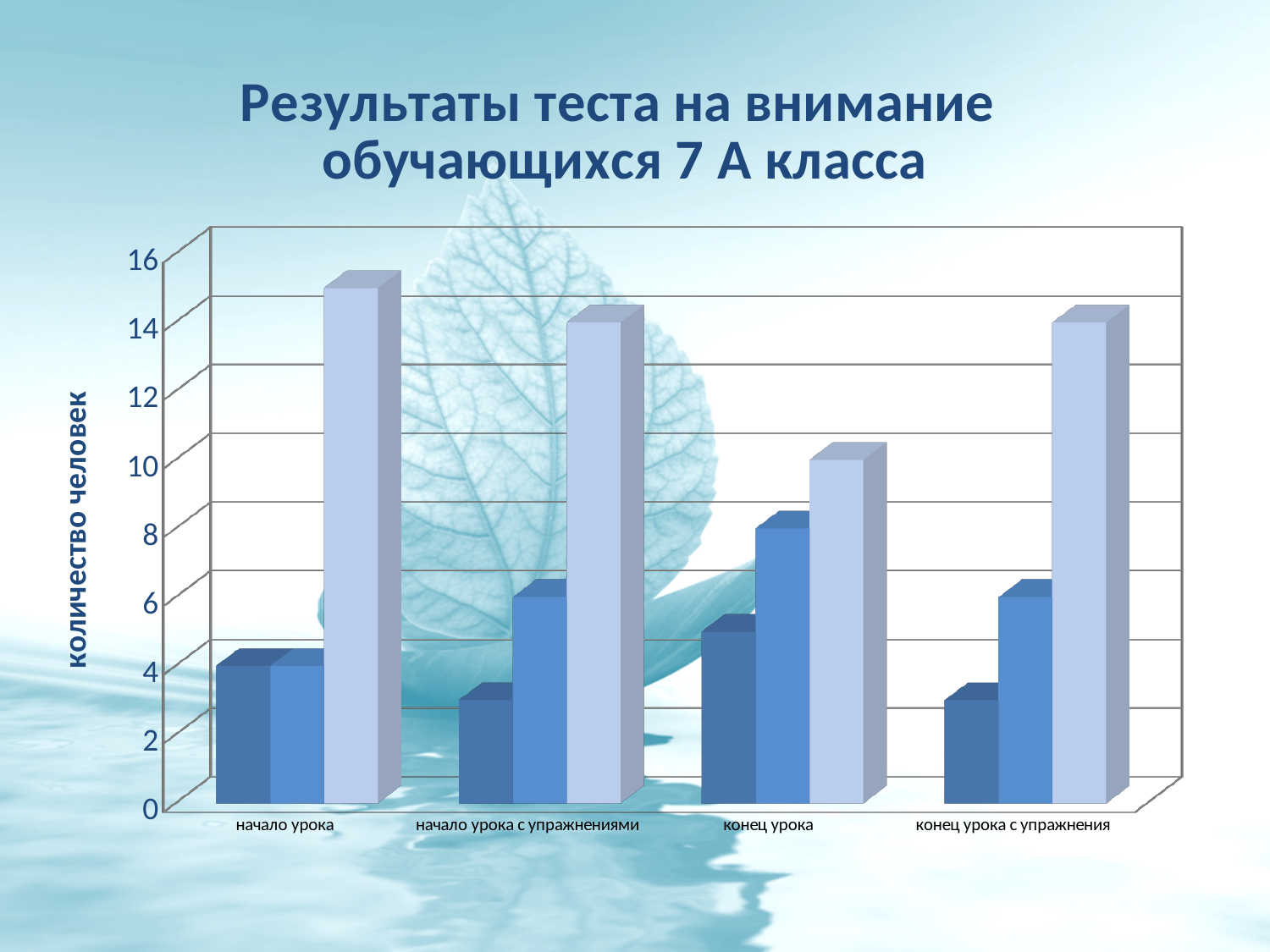
What is the title of the slide? Результаты теста на внимание обучающихся 7 А класса Is the value of the tallest (light-coloured) bar for 'начало урока' greater or less than 12? greater Which category has the tallest medium blue (second) bar? конец урока Which category has the shortest light-coloured (third) bar? конец урока What is the title of the chart's vertical axis? количество человек Is the value of the medium blue (second) bar for 'конец урока' greater or less than 6? greater How many categories are shown on the x axis of the chart? 4 Is the value of the light-coloured bar for 'начало урока с упражнениями' greater or less than 10? greater What kind of chart is shown on the slide? bar chart For 'конец урока', which is larger: the dark blue (first) bar or the light-coloured (third) bar? the light-coloured (third) bar